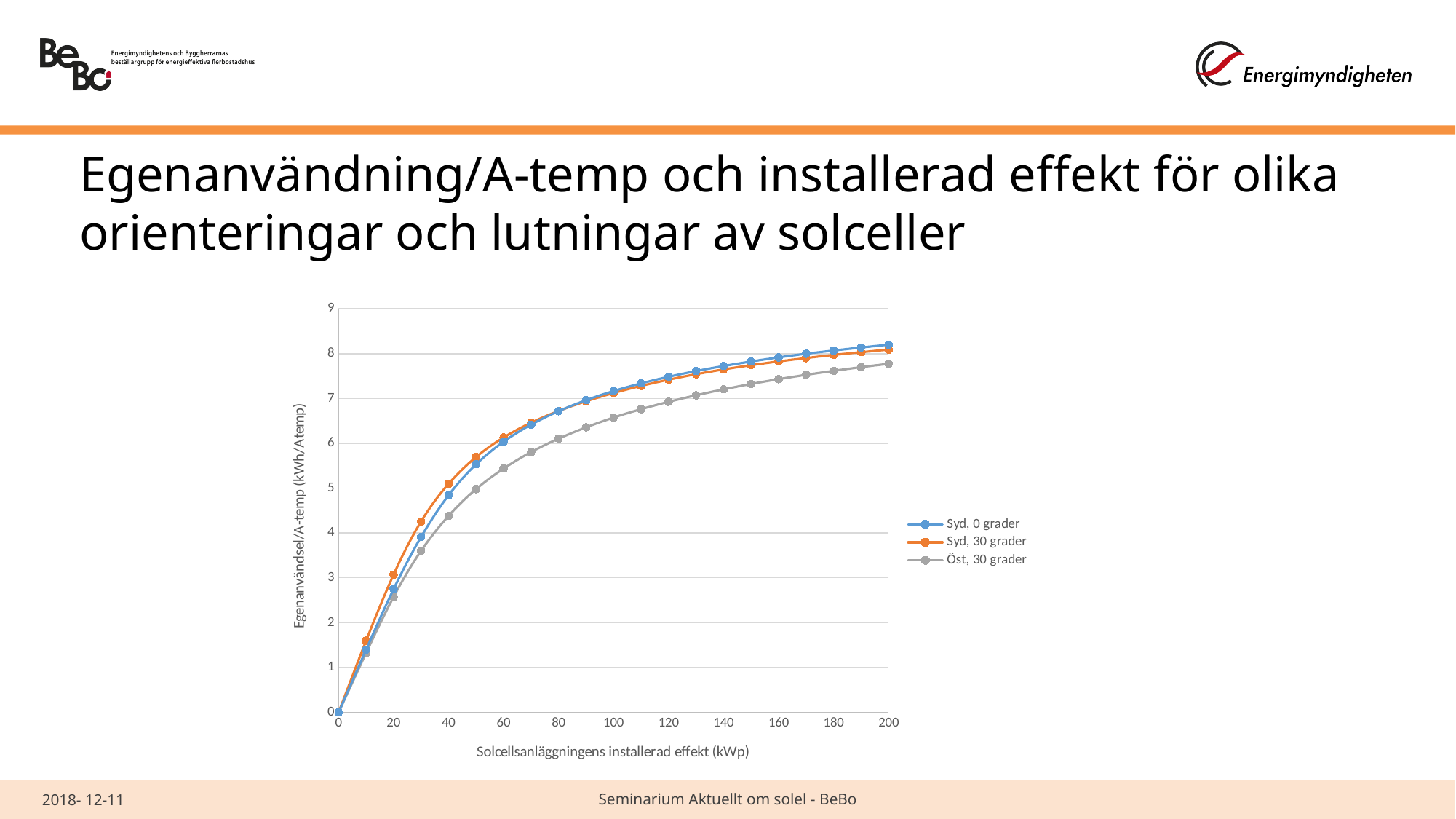
Do the values for Syd, 0 grader rise or fall as installed effect increases along the x axis? rise Which series is plotted in grey? Öst, 30 grader What kind of chart is shown on the slide? line chart Which series has the lowest value at 200 kWp? Öst, 30 grader How many series does the legend list? 3 What is the value for Öst, 30 grader at 0 kWp? 0 What is the label of the x axis? Solcellsanläggningens installerad effekt (kWp) At 40 kWp, which is larger: Syd, 30 grader or Öst, 30 grader? Syd, 30 grader Is the value for Öst, 30 grader at 200 kWp greater or less than 8? less Is the value for Syd, 0 grader at 200 kWp greater or less than 8? greater Is the value for Öst, 30 grader at 100 kWp greater or less than 7? less